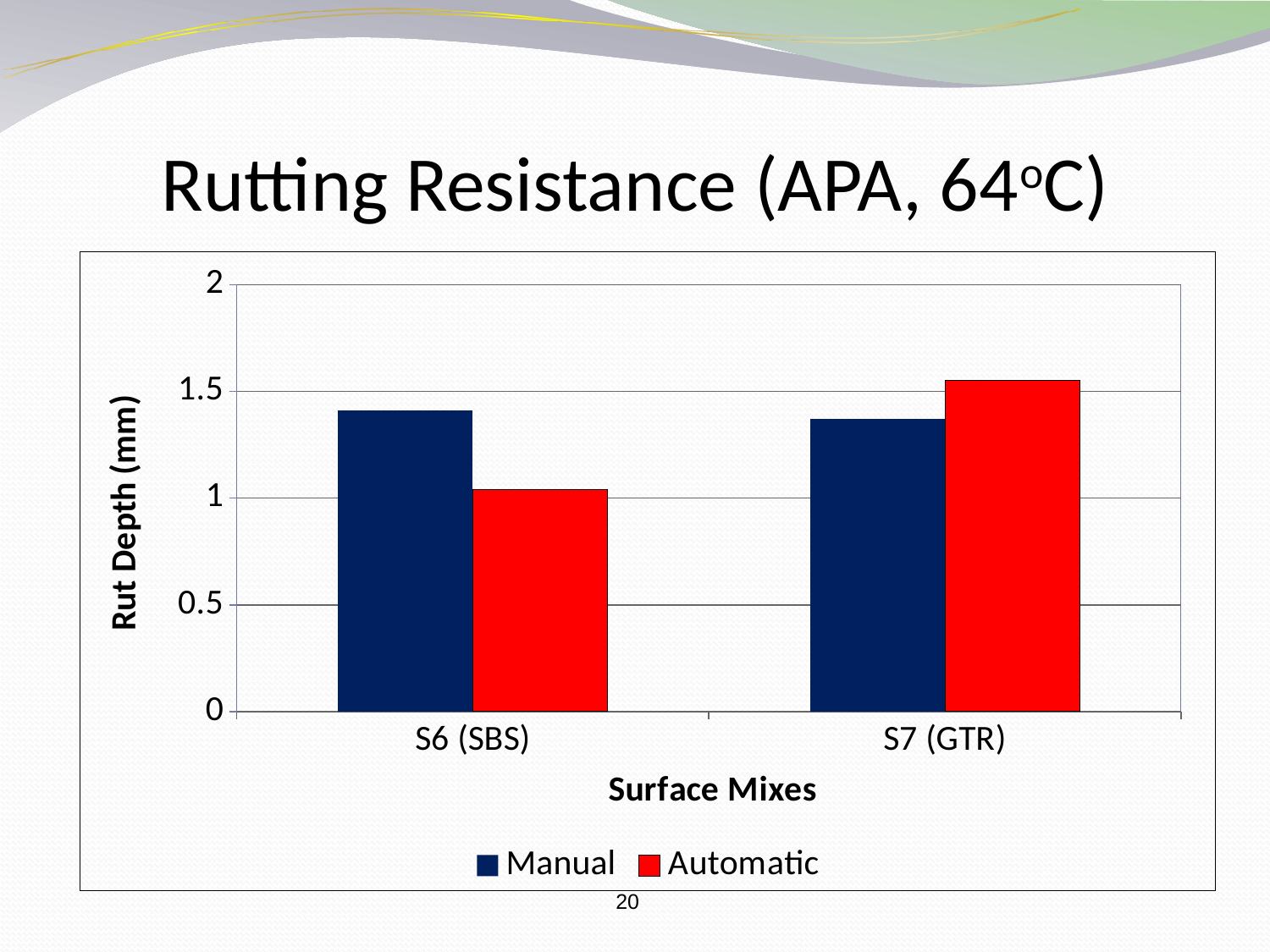
Is the Manual rut depth for S7 (GTR) greater or less than 1? greater What are the two series named in the legend? Manual and Automatic Which bar has the highest rut depth in the chart? Automatic for S7 (GTR) What kind of chart is shown on the slide? bar chart Which is larger, the Automatic rut depth for S6 (SBS) or for S7 (GTR)? S7 (GTR) For S6 (SBS), which is larger, the Manual or the Automatic rut depth? Manual How many series does the legend list? 2 For S7 (GTR), which is larger, the Manual or the Automatic rut depth? Automatic Which bar has the lowest rut depth in the chart? Automatic for S6 (SBS) What is the y-axis label of the chart? Rut Depth (mm) Is the Manual rut depth for S6 (SBS) greater or less than 1.5? less How many surface mixes are shown on the x axis? 2